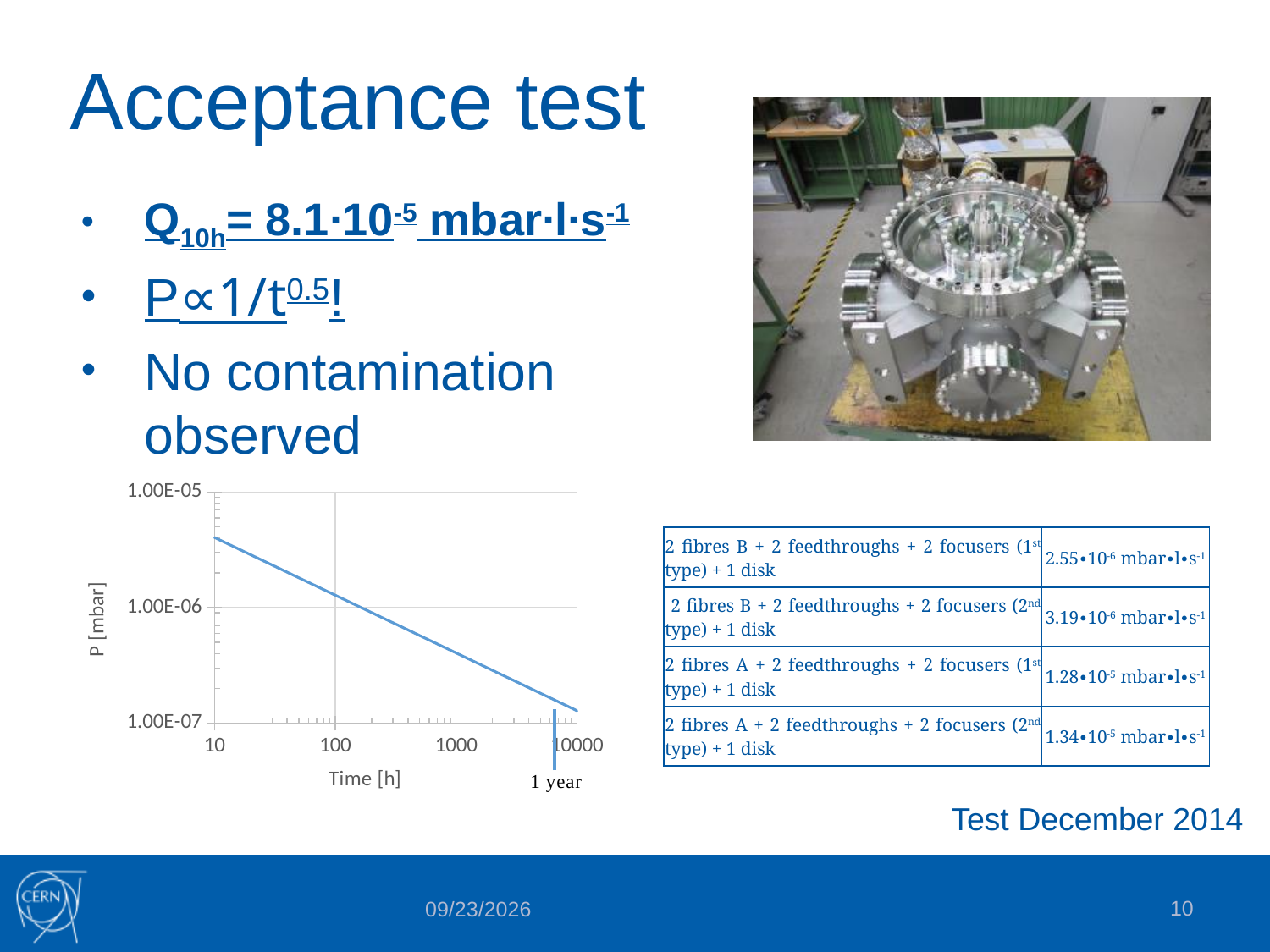
How many labelled tick values are shown on the x axis of the chart? 4 In the chart, is the pressure at 10000 h greater or less than 1.00E-06 mbar? less In the chart, is the pressure at 1000 h greater or less than 1.00E-06 mbar? less What is the highest value labelled on the y axis of the chart? 1.00E-05 In the chart, which has the higher pressure: 10 h or 10000 h? 10 h In the chart, is the pressure at 10 h greater or less than 1.00E-05 mbar? less In the chart of P [mbar] versus Time [h], do the values rise or fall as time increases? fall What kind of chart is shown at the bottom left of the slide? line chart What is the label of the y axis of the chart? P [mbar] What is the label of the x axis of the chart? Time [h]